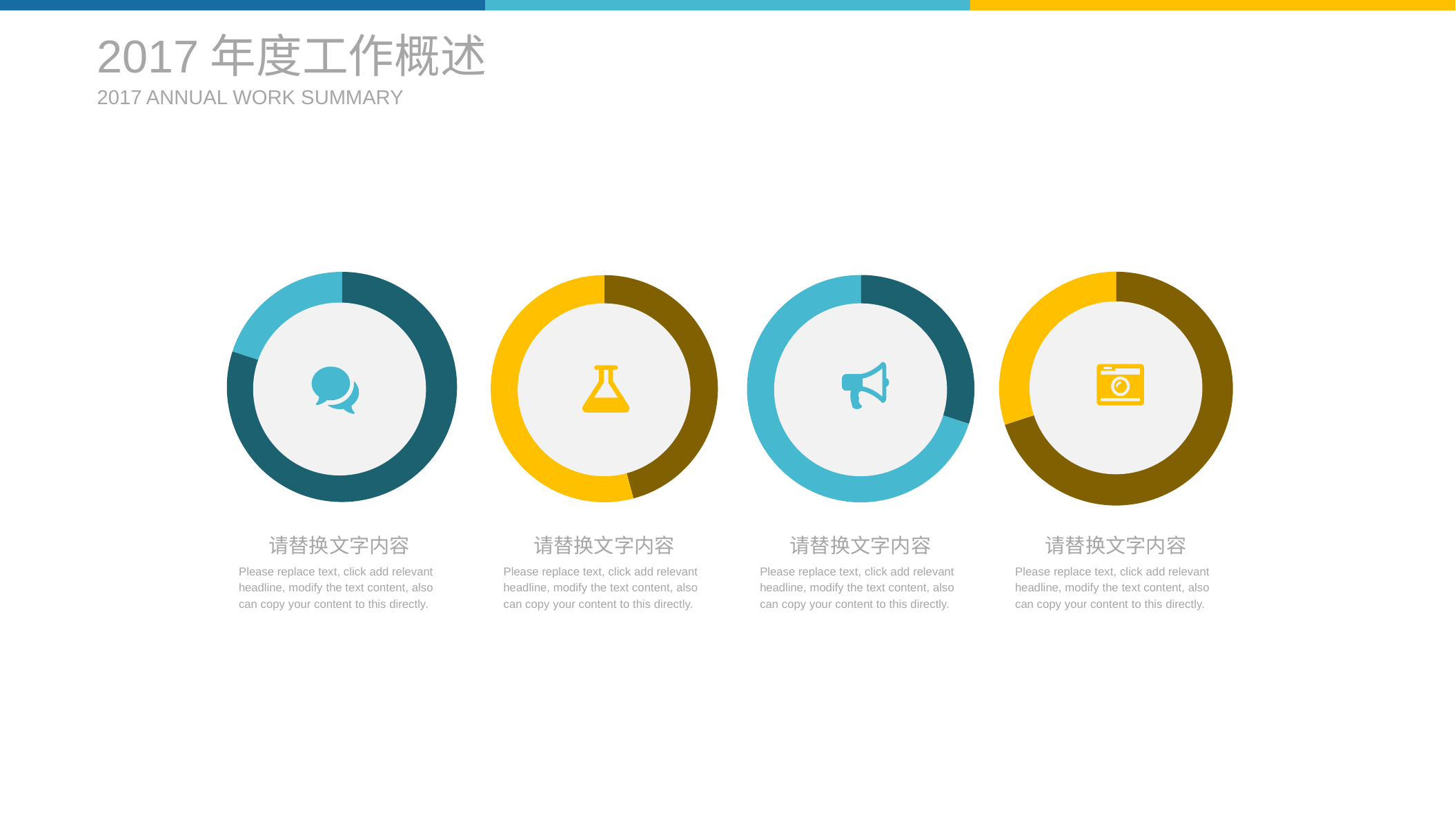
How many slices does the leftmost doughnut chart have? 2 In the rightmost doughnut chart, which slice is larger, the dark gold one or the yellow one? Dark gold In the leftmost doughnut chart, which slice is larger, the dark teal one or the light blue one? Dark teal What two colours are used in the second doughnut chart from the left? Yellow and dark gold What kind of chart is the leftmost chart on the slide? Doughnut chart How many slices does the rightmost doughnut chart have? 2 In the third doughnut chart from the left, which slice is larger, the light blue one or the dark teal one? Light blue How many doughnut charts are shown on the slide? 4